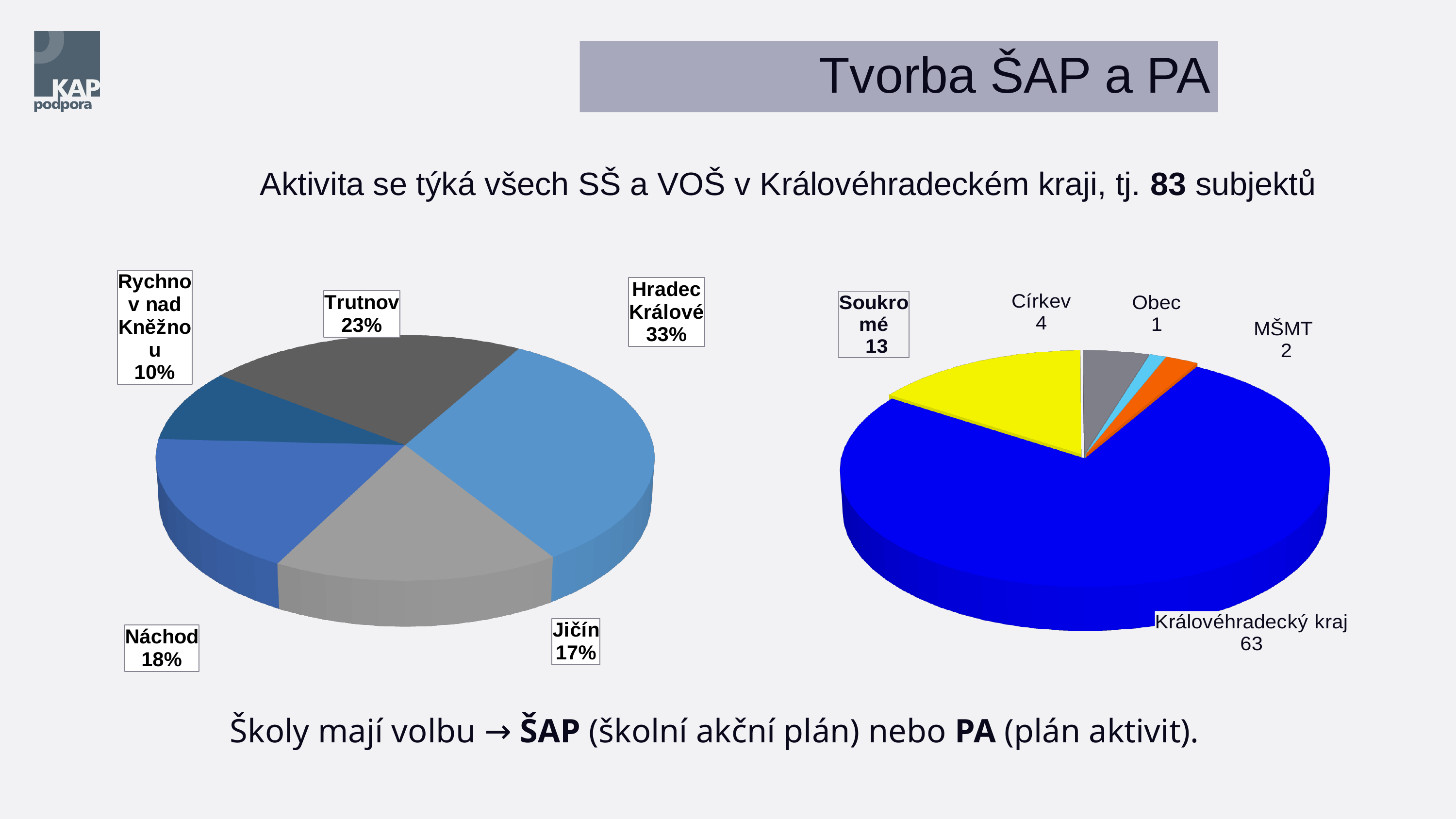
In the right pie chart, which category has the lowest value? Obec What type of chart is the right chart on the slide? Pie chart In the right pie chart, what value is shown for Soukromé? 13 In the left pie chart, which district has the largest share? Hradec Králové In the left pie chart, which district has the smallest share? Rychnov nad Kněžnou In the left pie chart, what percentage is shown for Náchod? 18% In the right pie chart, what is the total of all the slice values? 83 In the left pie chart, what is the difference in percentage points between Trutnov and Jičín? 6 In the left pie chart, what percentage is shown for Hradec Králové? 33% In the right pie chart, which is larger, Církev or MŠMT? Církev How many slices does the left pie chart have? 5 In the right pie chart, what value is shown for Královéhradecký kraj? 63